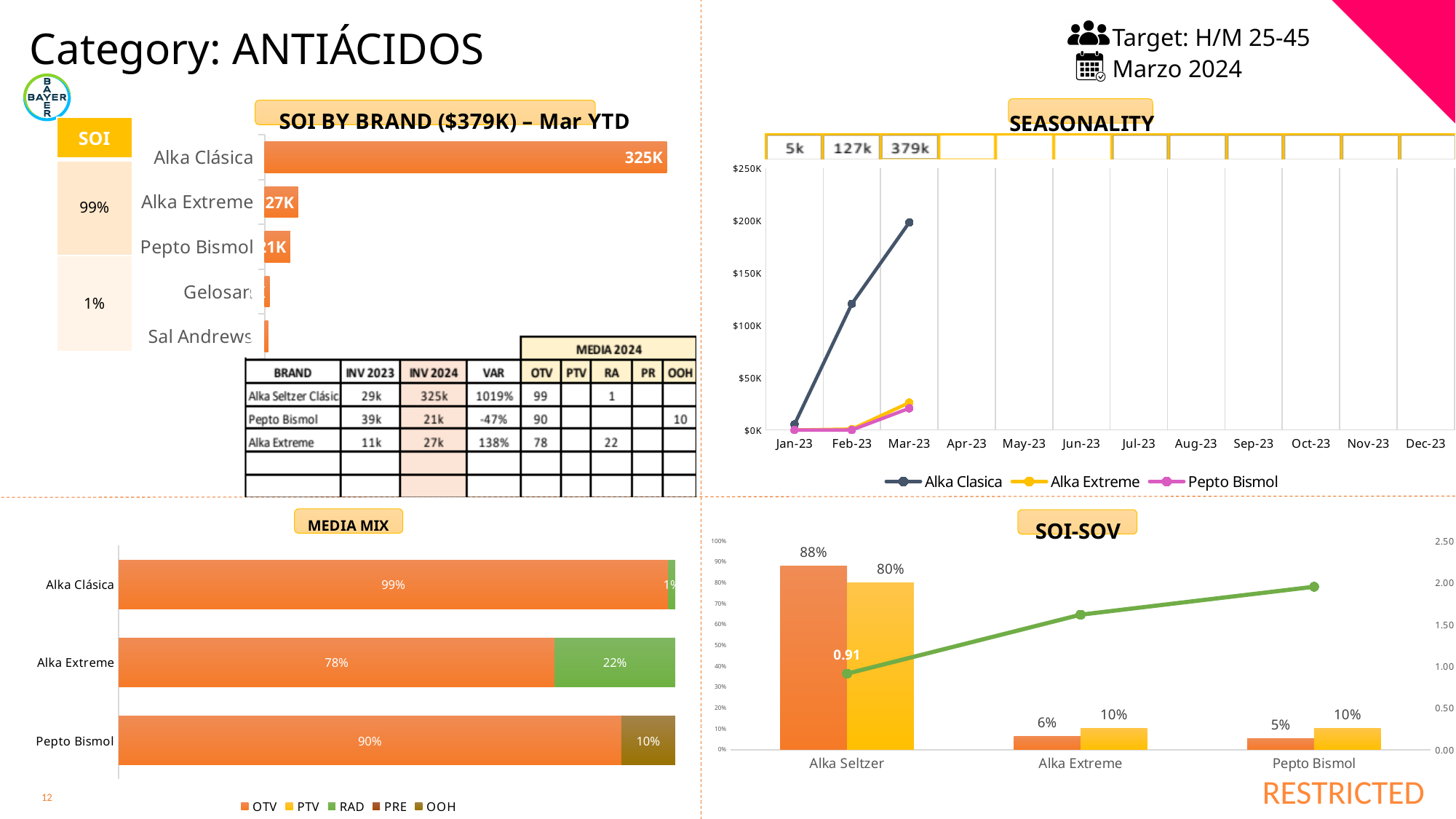
In the SOI BY BRAND chart, what is the value for Alka Clásica? 325K How many series does the legend of the SEASONALITY chart list? 3 What kind of chart is the MEDIA MIX chart? stacked bar chart In the SOI BY BRAND chart, which brand has the highest value? Alka Clásica In the SOI BY BRAND chart, what is the difference between Alka Extreme and Pepto Bismol? 6K How many brands are shown in the SOI BY BRAND chart? 5 In the SOI-SOV chart, what is the value of the line for Alka Seltzer? 0.91 In the MEDIA MIX chart, what share of Alka Extreme's media mix is RAD? 22% In the SEASONALITY chart, does the Alka Clasica line rise or fall from Jan-23 to Mar-23? rise In the SOI BY BRAND chart, what is the value for Alka Extreme? 27K In the MEDIA MIX chart, what share of Pepto Bismol's media mix is OTV? 90% In the SEASONALITY chart, is the value for Alka Clasica in Feb-23 greater or less than $100K? greater